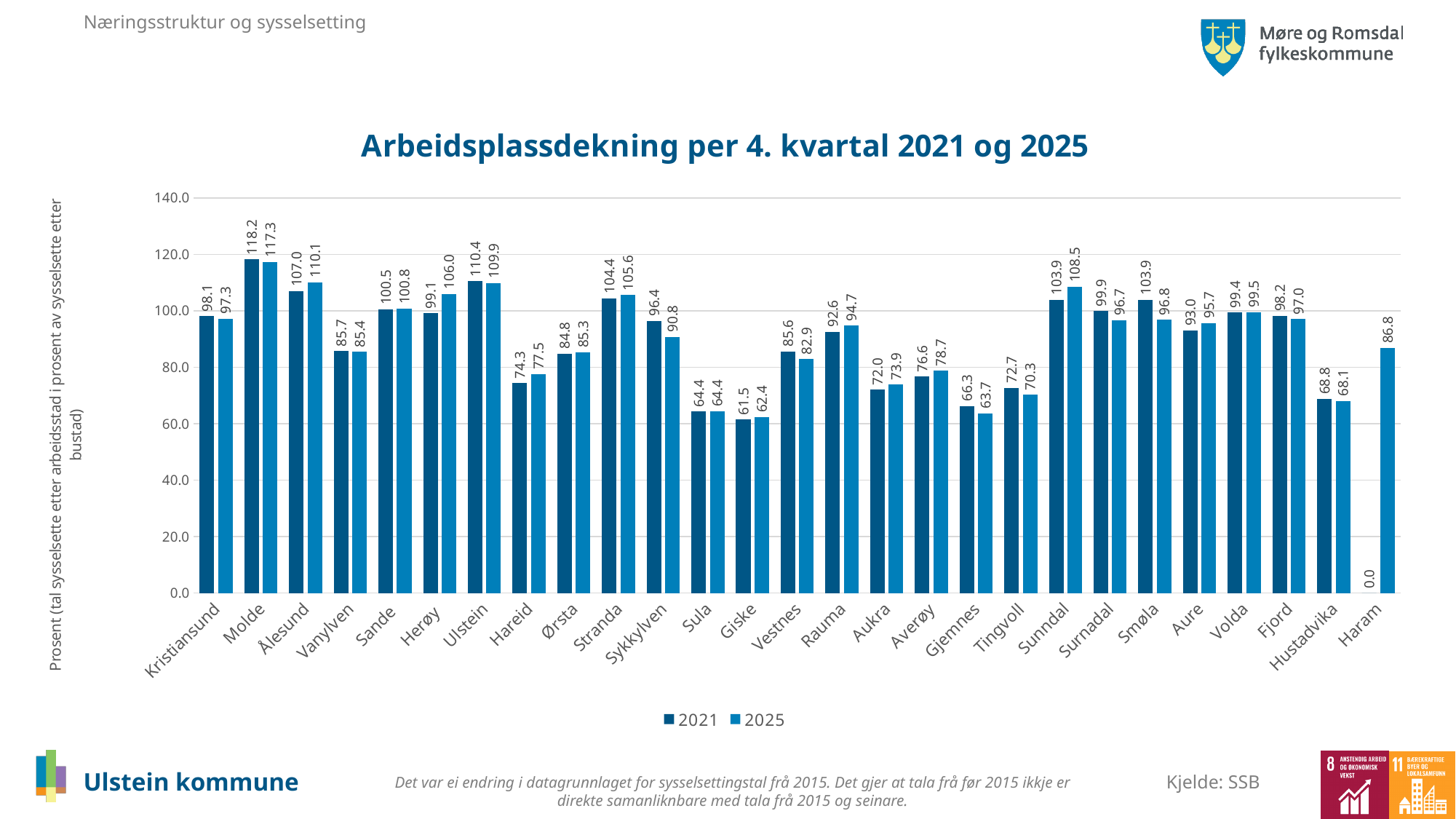
Is the 2025 value for Hareid greater or less than 80.0? less What is the difference between the 2021 and 2025 values for Sykkylven? 5.6 Which is larger for Smøla, the 2021 value or the 2025 value? 2021 What is the 2025 value for Haram? 86.8 What is the difference between the 2025 and 2021 values for Herøy? 6.9 What is the 2025 value for Sunndal? 108.5 Which municipality has the lowest 2025 value? Giske Which municipality has the highest 2021 value? Molde How many series does the legend list? 2 How many municipalities are shown on the x axis? 27 What type of chart is shown? bar chart What is the 2021 value for Ulstein? 110.4